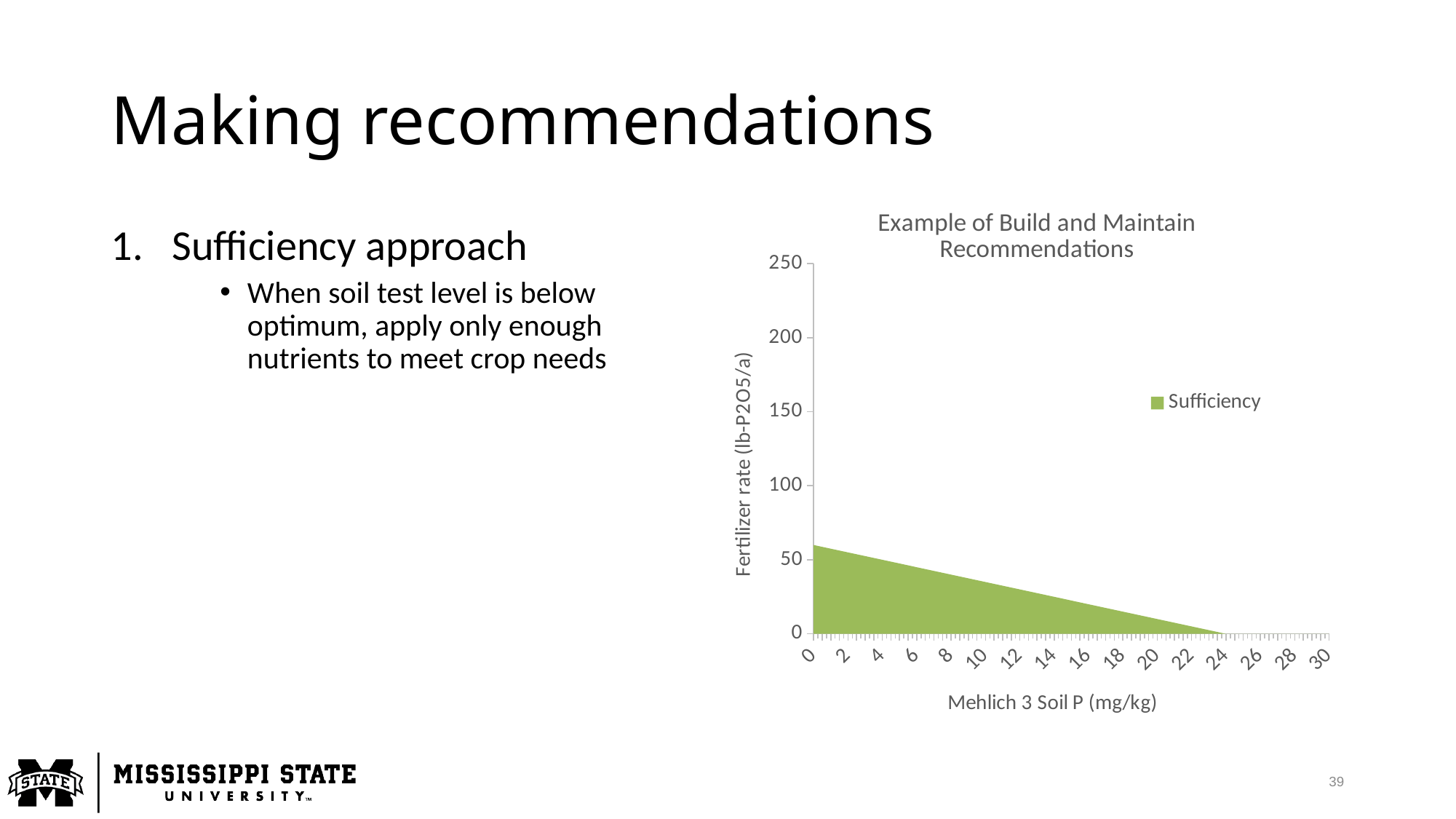
Which has the larger fertilizer rate: a Mehlich 3 Soil P of 4 mg/kg or 20 mg/kg? 4 mg/kg Is the fertilizer rate at a Mehlich 3 Soil P of 20 mg/kg greater or less than 50? less Does the fertilizer rate rise or fall as Mehlich 3 Soil P increases along the x axis? fall What kind of chart is shown on the slide? area chart At which Mehlich 3 Soil P value is the fertilizer rate highest? 0 What is the label of the y axis? Fertilizer rate (lb-P2O5/a) Is the fertilizer rate at a Mehlich 3 Soil P of 10 mg/kg greater or less than 50? less Is the fertilizer rate at a Mehlich 3 Soil P of 28 mg/kg greater or less than 50? less What series name appears in the chart's legend? Sufficiency How many series does the chart's legend list? 1 What is the title of the chart? Example of Build and Maintain Recommendations